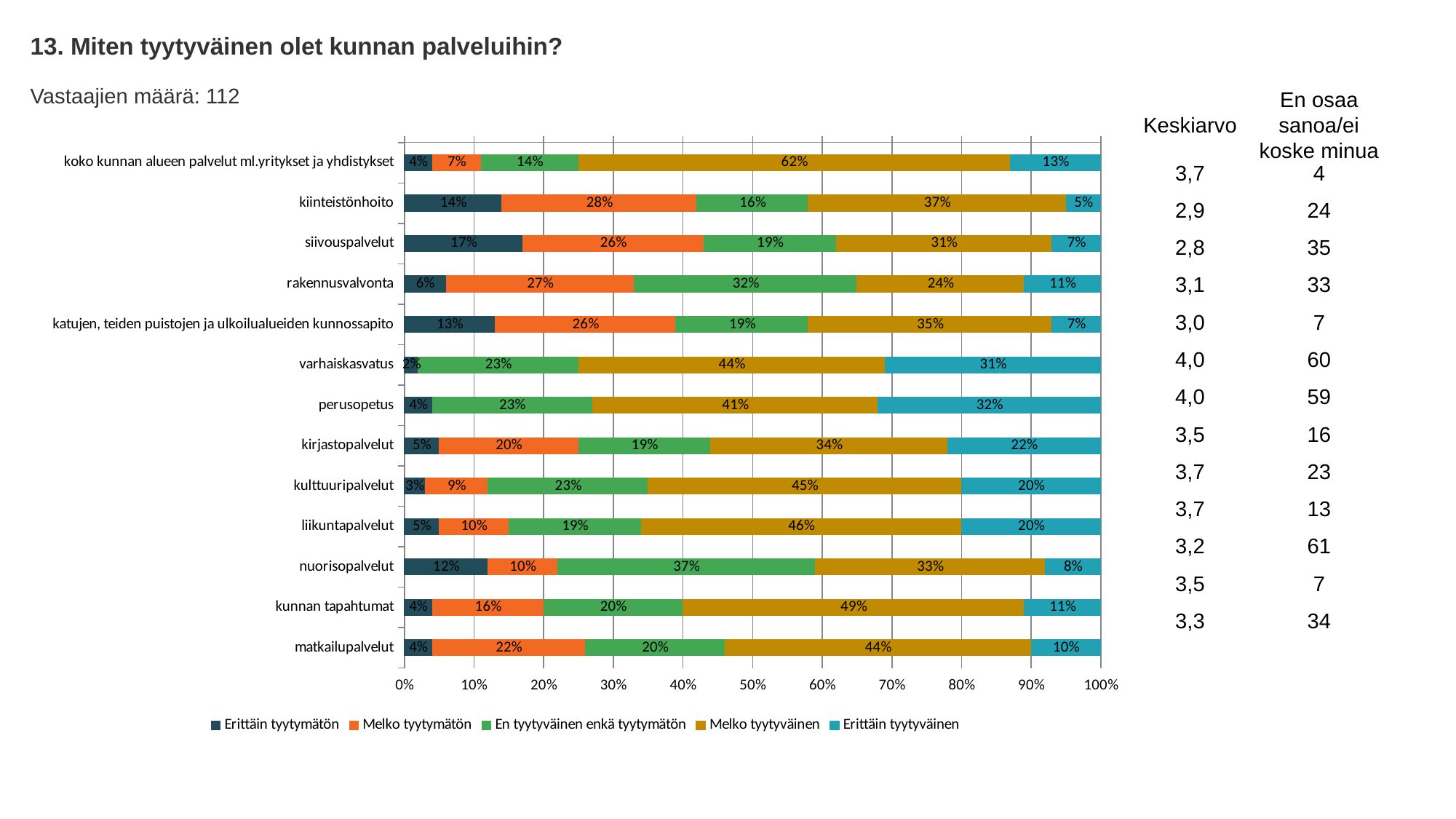
Which legend entry is shown in orange? Melko tyytymätön What kind of chart is shown on the slide? Stacked bar chart What is the Erittäin tyytyväinen value for perusopetus? 32% What is the Erittäin tyytymätön value for siivouspalvelut? 17% What is the Melko tyytyväinen value for koko kunnan alueen palvelut ml.yritykset ja yhdistykset? 62% What is the En tyytyväinen enkä tyytymätön value for nuorisopalvelut? 37% Which category has the highest Erittäin tyytymätön share? siivouspalvelut How many service categories are plotted on the chart? 13 Which category has the highest Melko tyytyväinen share? koko kunnan alueen palvelut ml.yritykset ja yhdistykset Which has the larger En tyytyväinen enkä tyytymätön share, nuorisopalvelut or rakennusvalvonta? nuorisopalvelut How many series does the legend list? 5 What is the difference in percentage points between the Erittäin tyytyväinen values for varhaiskasvatus and nuorisopalvelut? 23 percentage points